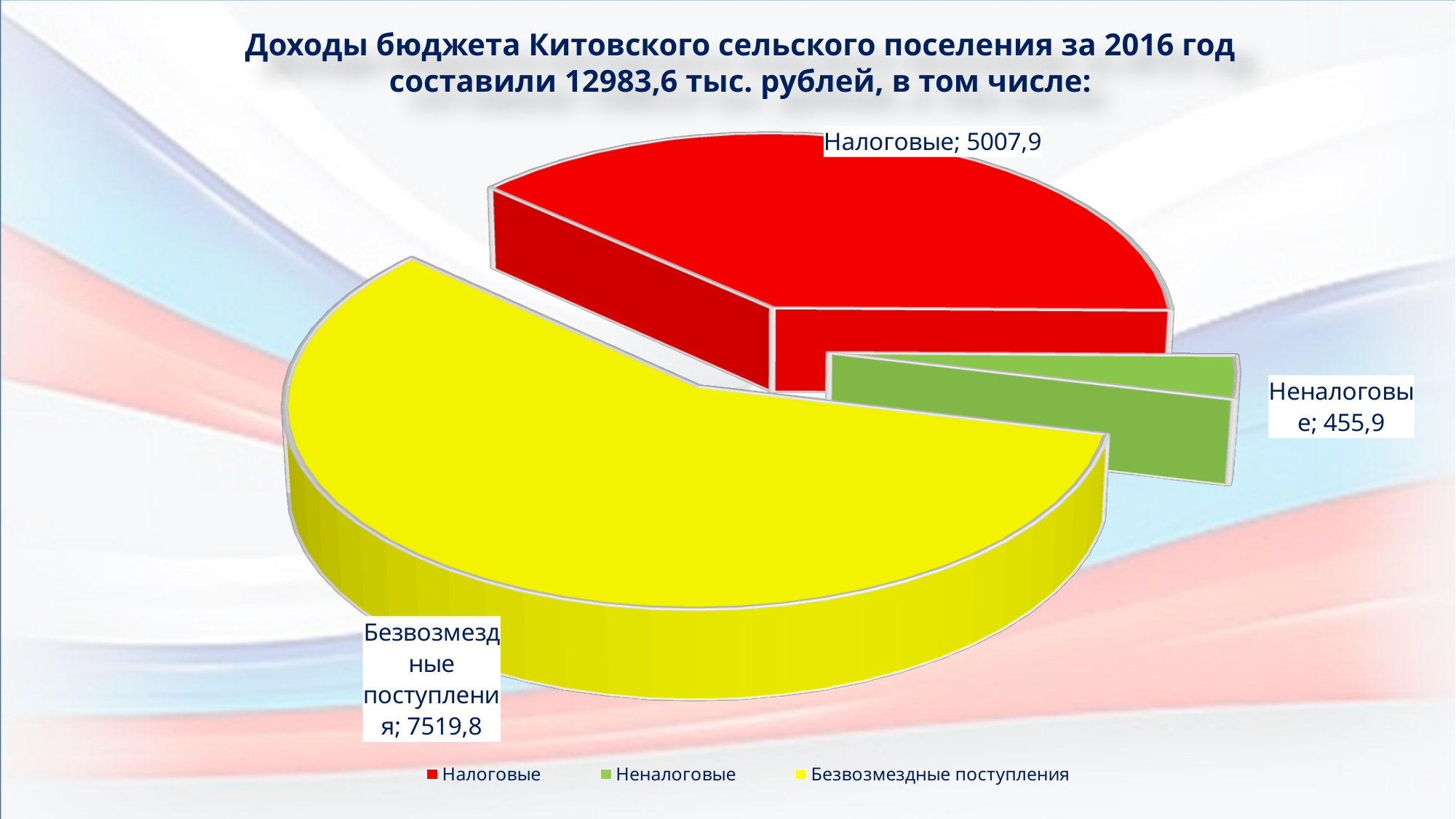
What is the value of the Безвозмездные поступления slice? 7519,8 What is the total of all three slices, as stated in the slide title (in тыс. рублей)? 12983,6 What is the difference between the Безвозмездные поступления value and the Налоговые value? 2511,9 What is the value of the Неналоговые slice? 455,9 What colour is the Безвозмездные поступления slice? Yellow What is the difference between the Налоговые value and the Неналоговые value? 4552 What kind of chart is shown on the slide? Pie chart How many slices does the pie chart have? 3 What is the value of the Налоговые slice? 5007,9 Which is larger, Налоговые or Неналоговые? Налоговые Which category has the smallest slice of the pie? Неналоговые Which category has the largest slice of the pie? Безвозмездные поступления